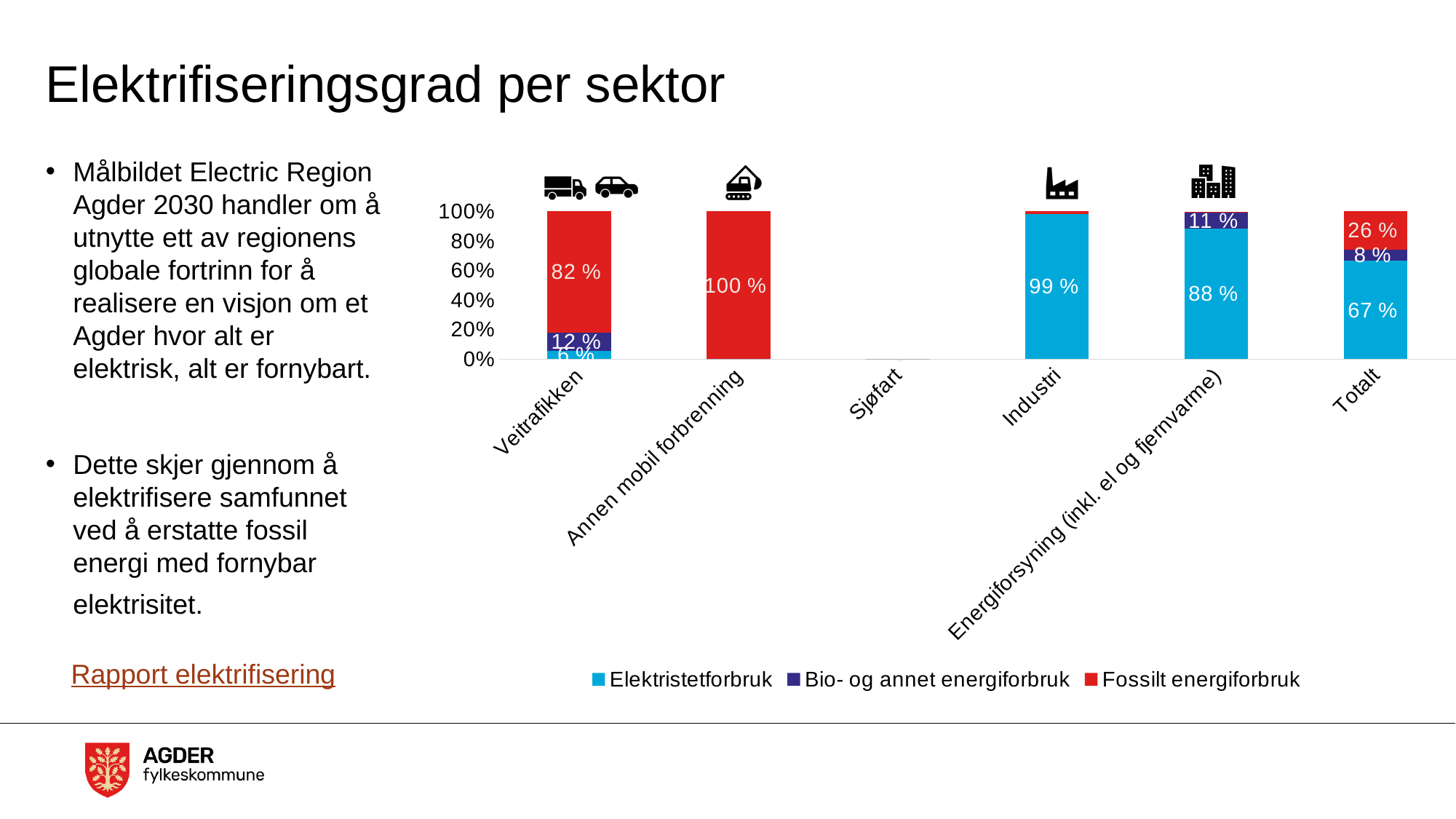
What is the Fossilt energiforbruk value for Veitrafikken? 82 % Which is larger, the Elektristetforbruk value for Industri or for Energiforsyning (inkl. el og fjernvarme)? Industri How many categories are shown on the x axis? 6 What is the difference between the Elektristetforbruk value for Energiforsyning (inkl. el og fjernvarme) and for Totalt? 21 % What is the Elektristetforbruk value for Veitrafikken? 6 % How many series does the chart legend list? 3 What is the Fossilt energiforbruk value for Totalt? 26 % What is the Bio- og annet energiforbruk value for Energiforsyning (inkl. el og fjernvarme)? 11 % What is the Elektristetforbruk value for Industri? 99 % Which category has the highest Fossilt energiforbruk value? Annen mobil forbrenning What kind of chart is shown on the slide? Stacked bar chart Which series is shown in red in the chart? Fossilt energiforbruk